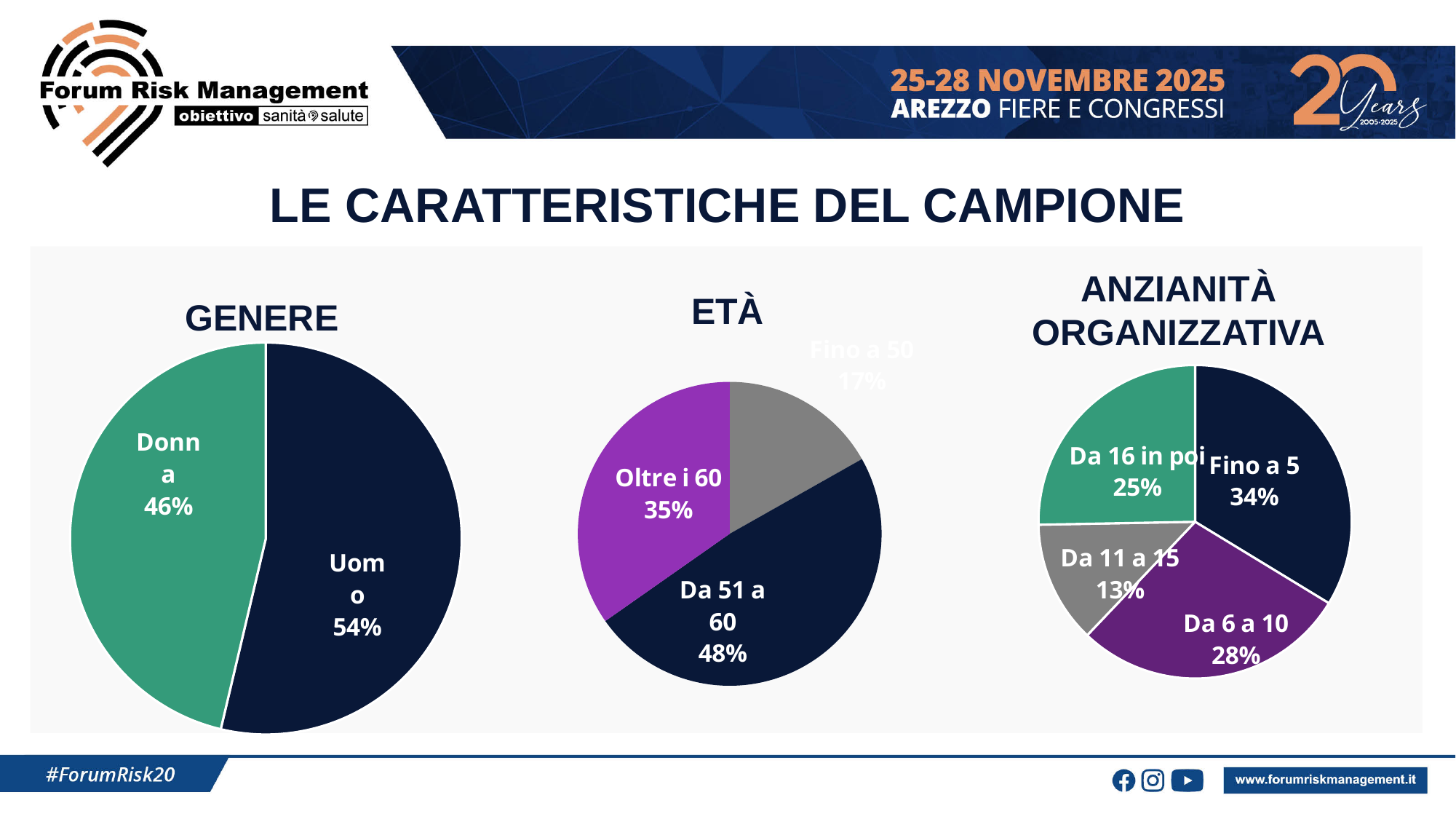
How many slices does the ETÀ chart have? 3 In the ANZIANITÀ ORGANIZZATIVA chart, which category has the smallest share? Da 11 a 15 What type of chart is used for the GENERE data? Pie chart In the GENERE chart, what percentage is shown for Uomo? 54% In the ETÀ chart, what percentage is shown for Da 51 a 60? 48% In the GENERE chart, what is the difference in percentage points between Uomo and Donna? 8 In the ANZIANITÀ ORGANIZZATIVA chart, what is the difference in percentage points between Fino a 5 and Da 16 in poi? 9 In the GENERE chart, which category has the larger share, Donna or Uomo? Uomo In the ETÀ chart, which age group has the largest share? Da 51 a 60 In the ETÀ chart, what percentage is shown for Oltre i 60? 35% In the ANZIANITÀ ORGANIZZATIVA chart, what percentage is shown for Da 6 a 10? 28% In the GENERE chart, what percentage is shown for Donna? 46%